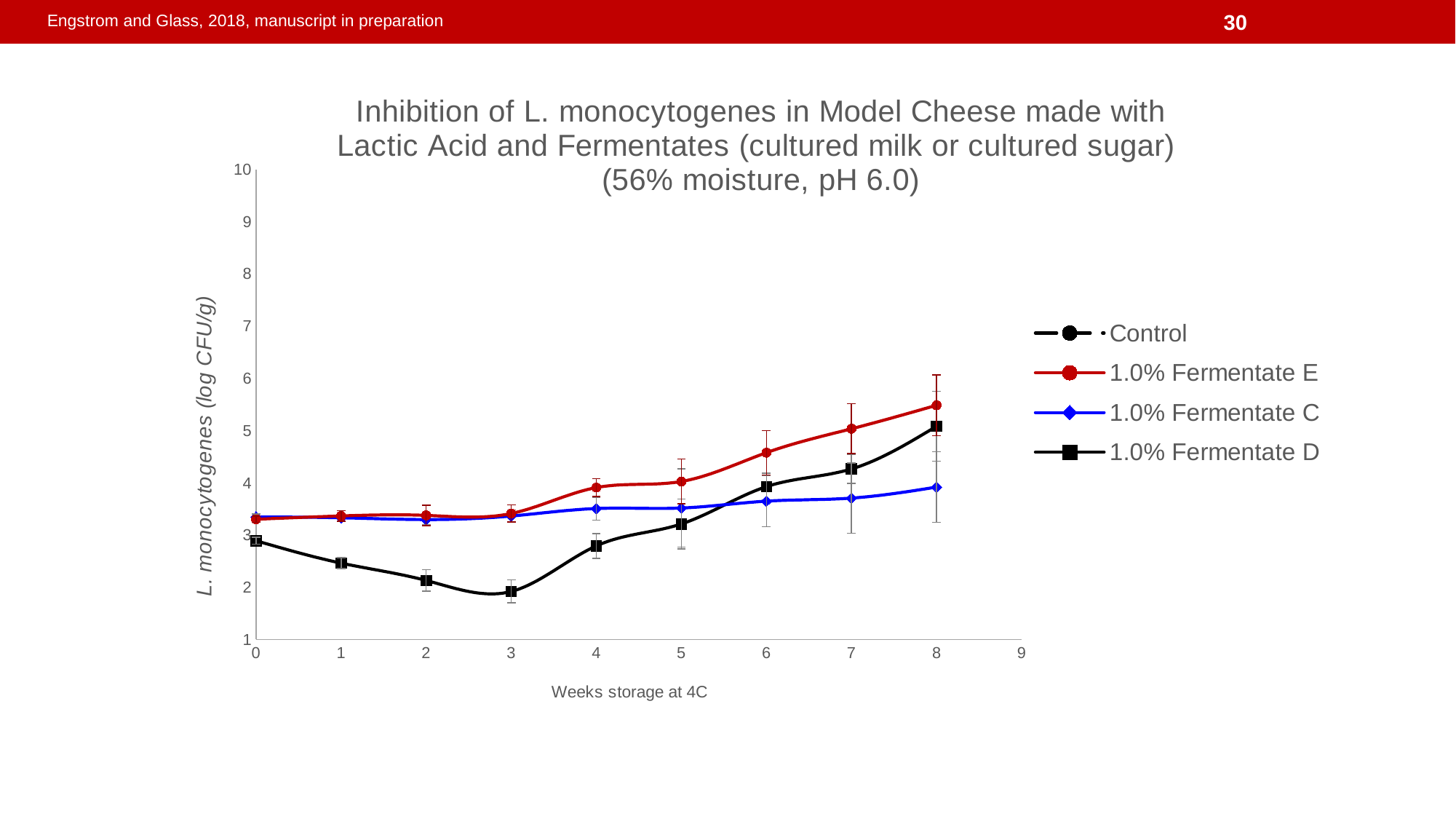
What kind of chart is shown on the slide? Line chart Is the value for 1.0% Fermentate E at week 8 greater or less than 5? greater Is the value for 1.0% Fermentate E at week 6 greater or less than 4? greater Which series has the lowest value at week 3? 1.0% Fermentate D How many series does the legend list? 4 At week 8, which is larger: the value for 1.0% Fermentate E or 1.0% Fermentate C? 1.0% Fermentate E Does the value for 1.0% Fermentate D rise or fall from week 0 to week 3? fall Which series has the highest value at week 8? 1.0% Fermentate E What is the x-axis title of the chart? Weeks storage at 4C Which series is plotted with a blue line and diamond markers? 1.0% Fermentate C